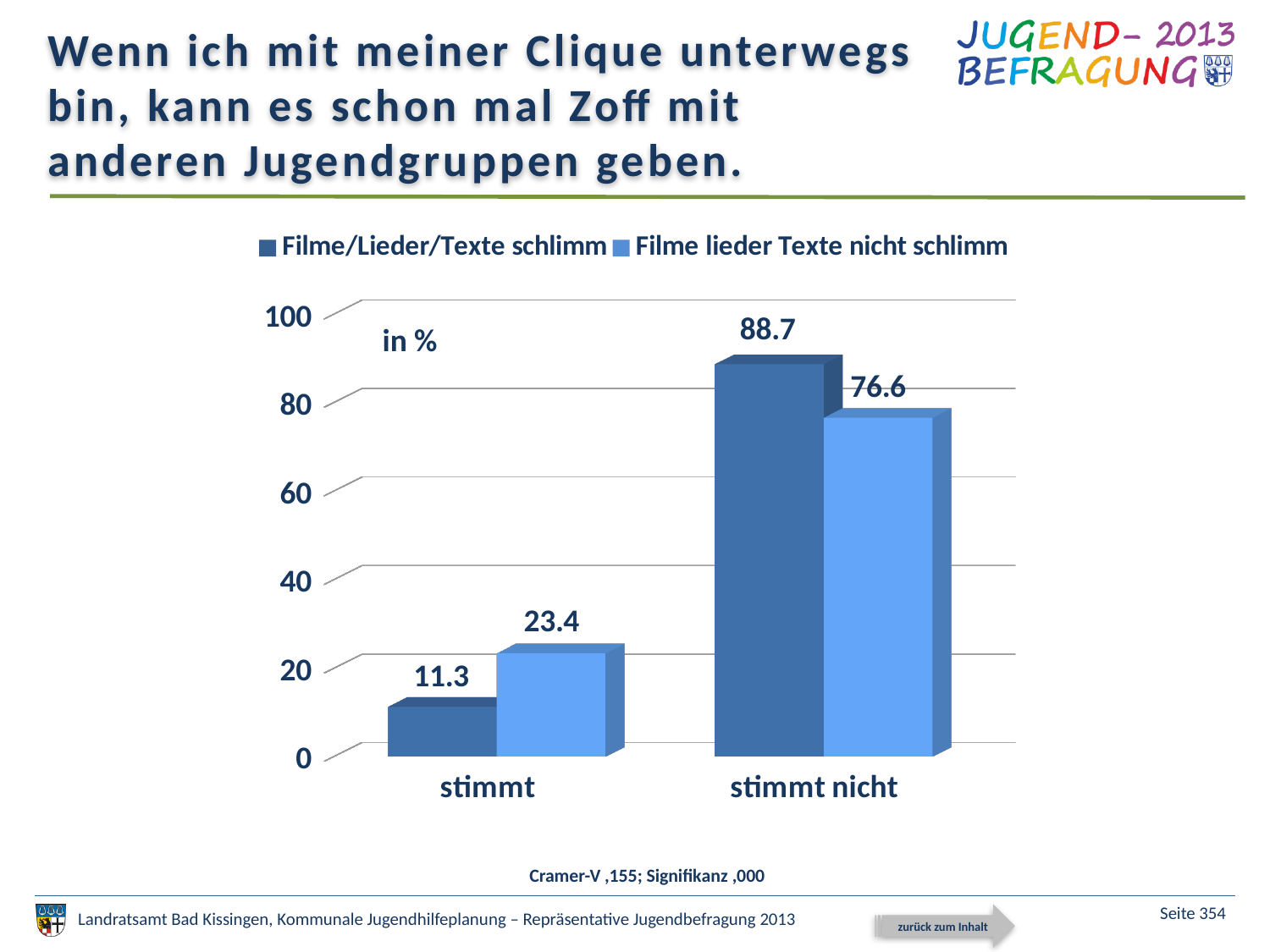
Which category has the lowest value for the "Filme lieder Texte nicht schlimm" series? stimmt What is the value for "Filme lieder Texte nicht schlimm" in the "stimmt nicht" category? 76.6 In the "stimmt" category, which series has the larger value? Filme lieder Texte nicht schlimm What is the difference between the two series in the "stimmt nicht" category? 12.1 How many series does the legend list? 2 What is the value for "Filme/Lieder/Texte schlimm" in the "stimmt" category? 11.3 What is the difference between the two series in the "stimmt" category? 12.1 What is the value for "Filme lieder Texte nicht schlimm" in the "stimmt" category? 23.4 How many categories are shown on the x axis? 2 What kind of chart is shown on the slide? bar chart Which category has the highest value for the "Filme/Lieder/Texte schlimm" series? stimmt nicht What is the value for "Filme/Lieder/Texte schlimm" in the "stimmt nicht" category? 88.7